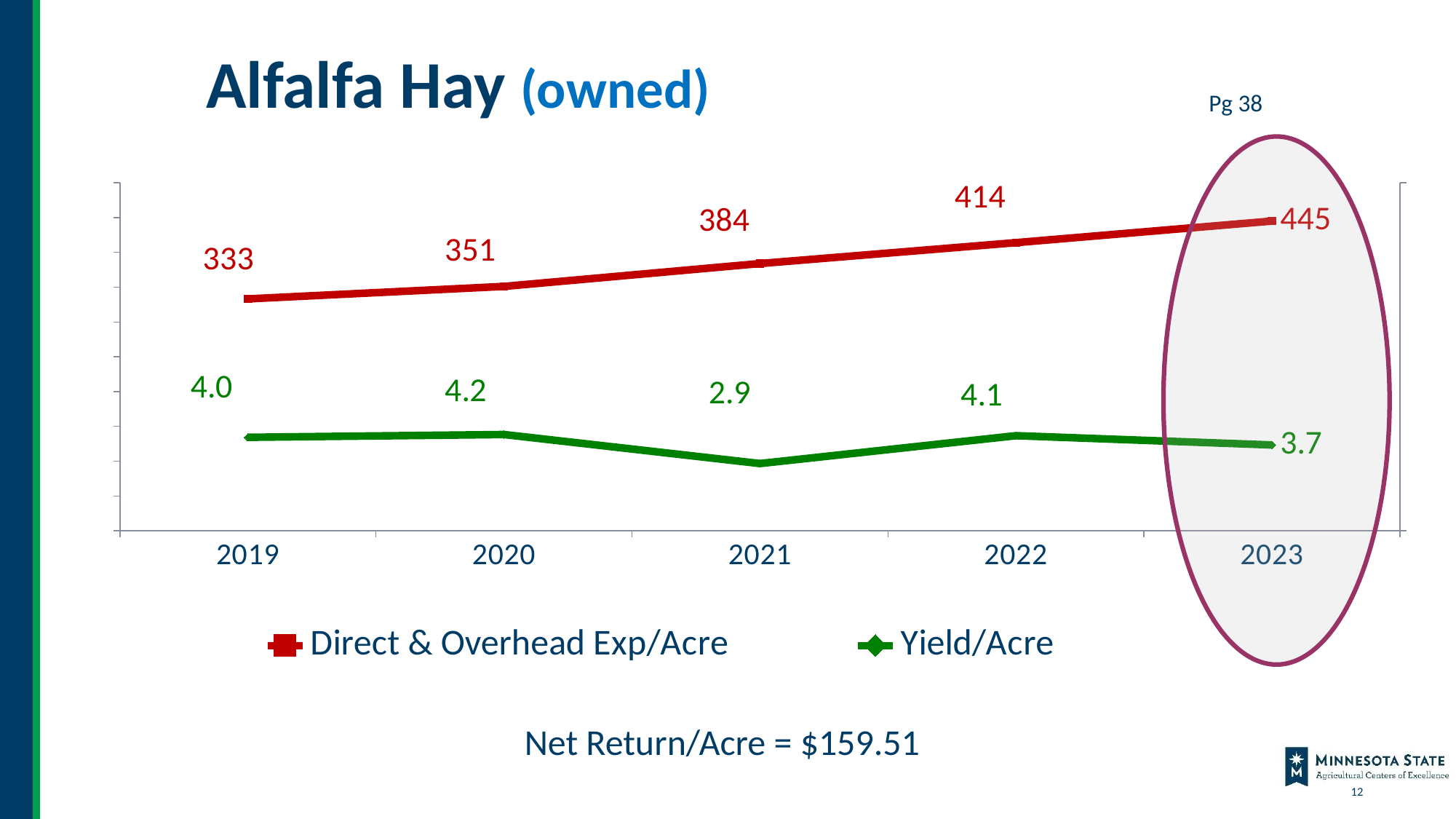
What is the difference in Direct & Overhead Exp/Acre between 2023 and 2019? 112 What is the Direct & Overhead Exp/Acre value for 2021? 384 What kind of chart is shown on the slide? Line chart Does Direct & Overhead Exp/Acre rise or fall from 2019 to 2023? Rise What is the Yield/Acre value for 2020? 4.2 What is the Direct & Overhead Exp/Acre value for 2023? 445 What is the difference in Yield/Acre between 2020 and 2021? 1.3 Which year has the higher Yield/Acre, 2022 or 2023? 2022 How many series does the legend list? 2 In which year is Yield/Acre lowest? 2021 How many years are shown on the x axis? 5 In which year is Direct & Overhead Exp/Acre highest? 2023